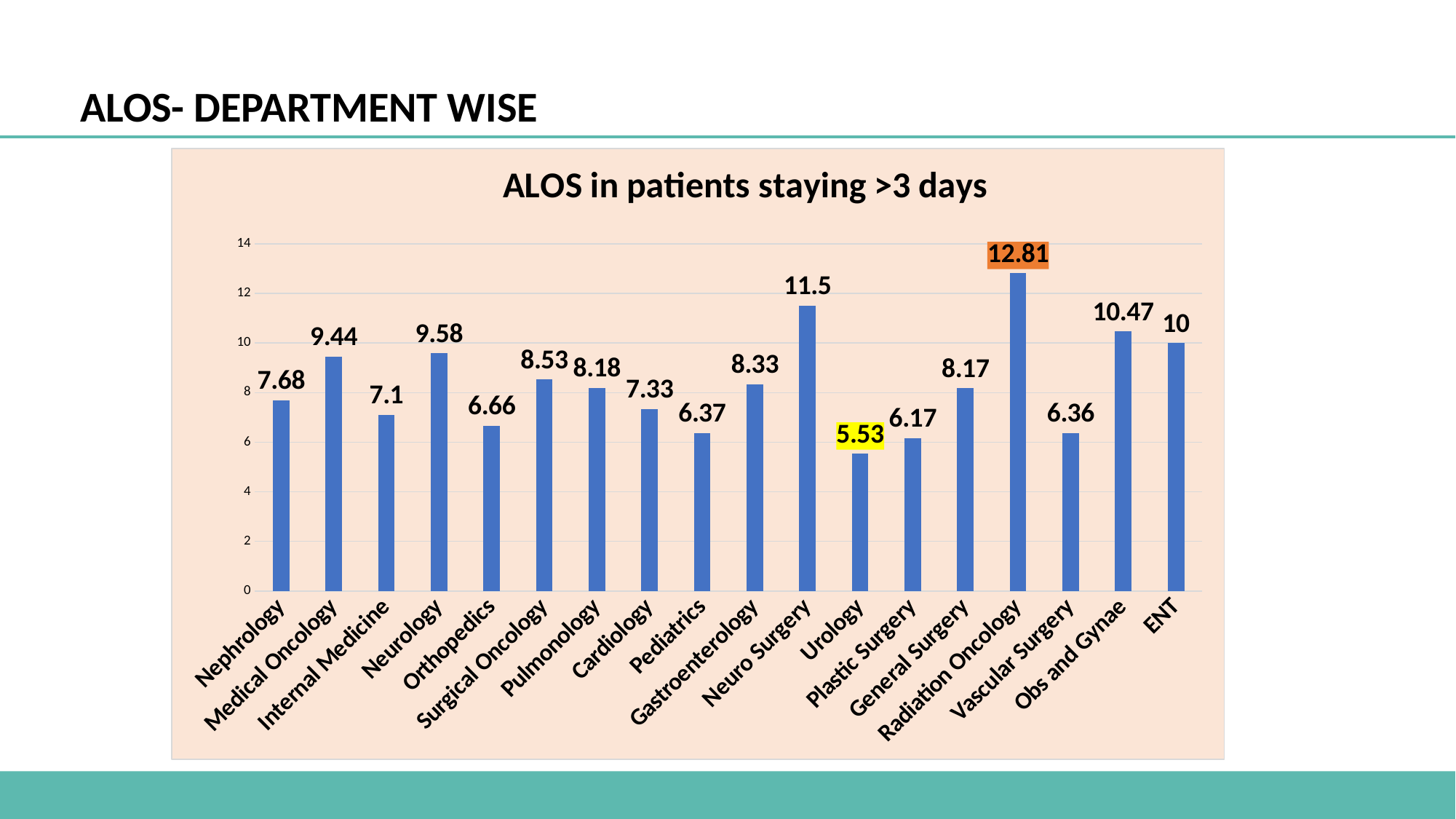
What is the difference between the ALOS for Radiation Oncology and Urology? 7.28 What is the difference between the ALOS for ENT and Cardiology? 2.67 What is the ALOS value for Internal Medicine? 7.1 Is the value for Pediatrics greater or less than 8? less What is the ALOS value for Obs and Gynae? 10.47 Which has a higher ALOS, Medical Oncology or Neurology? Neurology Which department has the highest ALOS? Radiation Oncology What is the ALOS value for Neuro Surgery? 11.5 Which department has the lowest ALOS? Urology How many departments are shown in the chart? 18 What kind of chart is shown on the slide? Bar chart What is the title of the chart? ALOS in patients staying >3 days